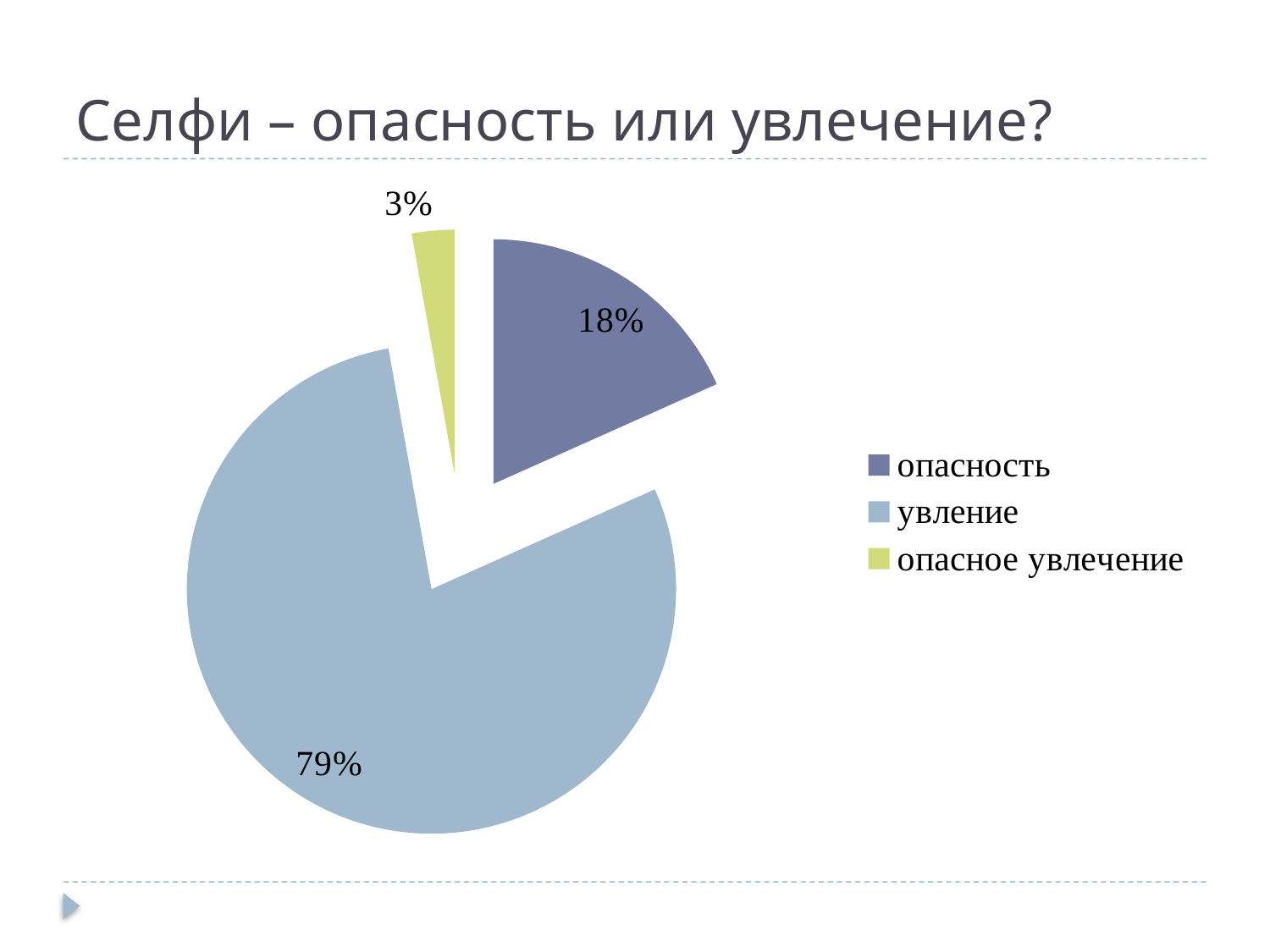
How many slices does the pie chart have? 3 What percentage of the pie is labelled for "опасность"? 18% Which category has the smallest slice of the pie? опасное увлечение How many entries does the legend list? 3 What is the difference in percentage points between the "увление" slice and the "опасность" slice? 61 What colour is the slice for "опасное увлечение"? yellow-green What percentage of the pie is labelled for "опасное увлечение"? 3% Which slice is larger, "опасность" or "опасное увлечение"? опасность What percentage of the pie is labelled for "увление"? 79% What is the title of the slide containing the chart? Селфи – опасность или увлечение? Which category has the largest slice of the pie? увление What kind of chart is shown on the slide? pie chart